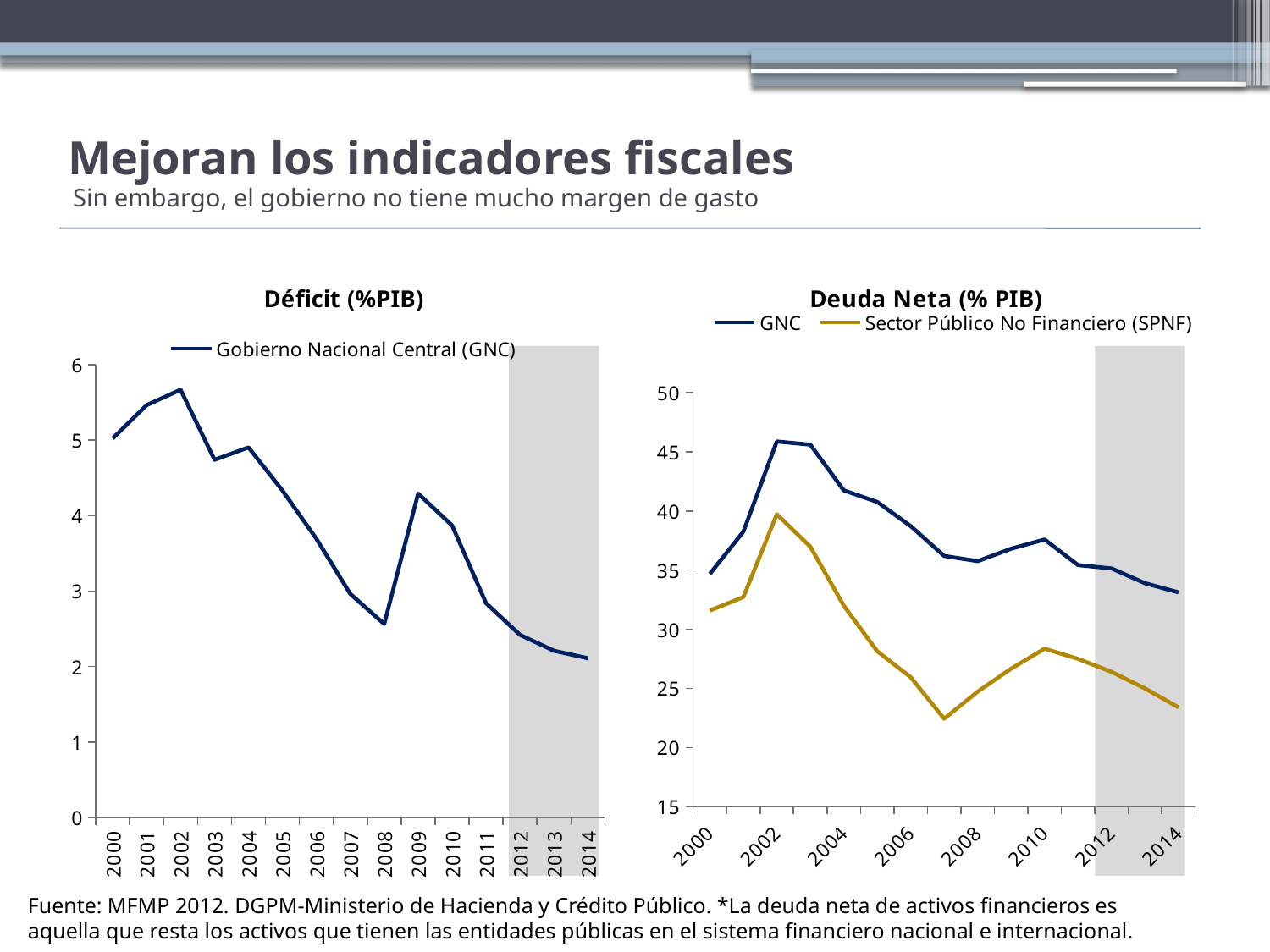
In the right chart 'Deuda Neta (% PIB)', in which year does the Sector Público No Financiero (SPNF) series reach its lowest value? 2007 In the left chart 'Déficit (%PIB)', which year has the highest deficit? 2002 In the right chart 'Deuda Neta (% PIB)', which series is higher in 2014, GNC or Sector Público No Financiero (SPNF)? GNC In the left chart 'Déficit (%PIB)', is the value for 2008 greater or less than 3? less What kind of chart is the left chart titled 'Déficit (%PIB)'? line chart In the left chart 'Déficit (%PIB)', how many years are plotted on the x axis? 15 In the left chart 'Déficit (%PIB)', is the value for 2009 greater or less than 4? greater In the right chart 'Deuda Neta (% PIB)', how many series does the legend list? 2 In the left chart 'Déficit (%PIB)', which year has the lowest deficit? 2014 In the right chart 'Deuda Neta (% PIB)', does the GNC series rise or fall between 2003 and 2008? fall In the right chart 'Deuda Neta (% PIB)', is the GNC value for 2002 greater or less than 45? greater